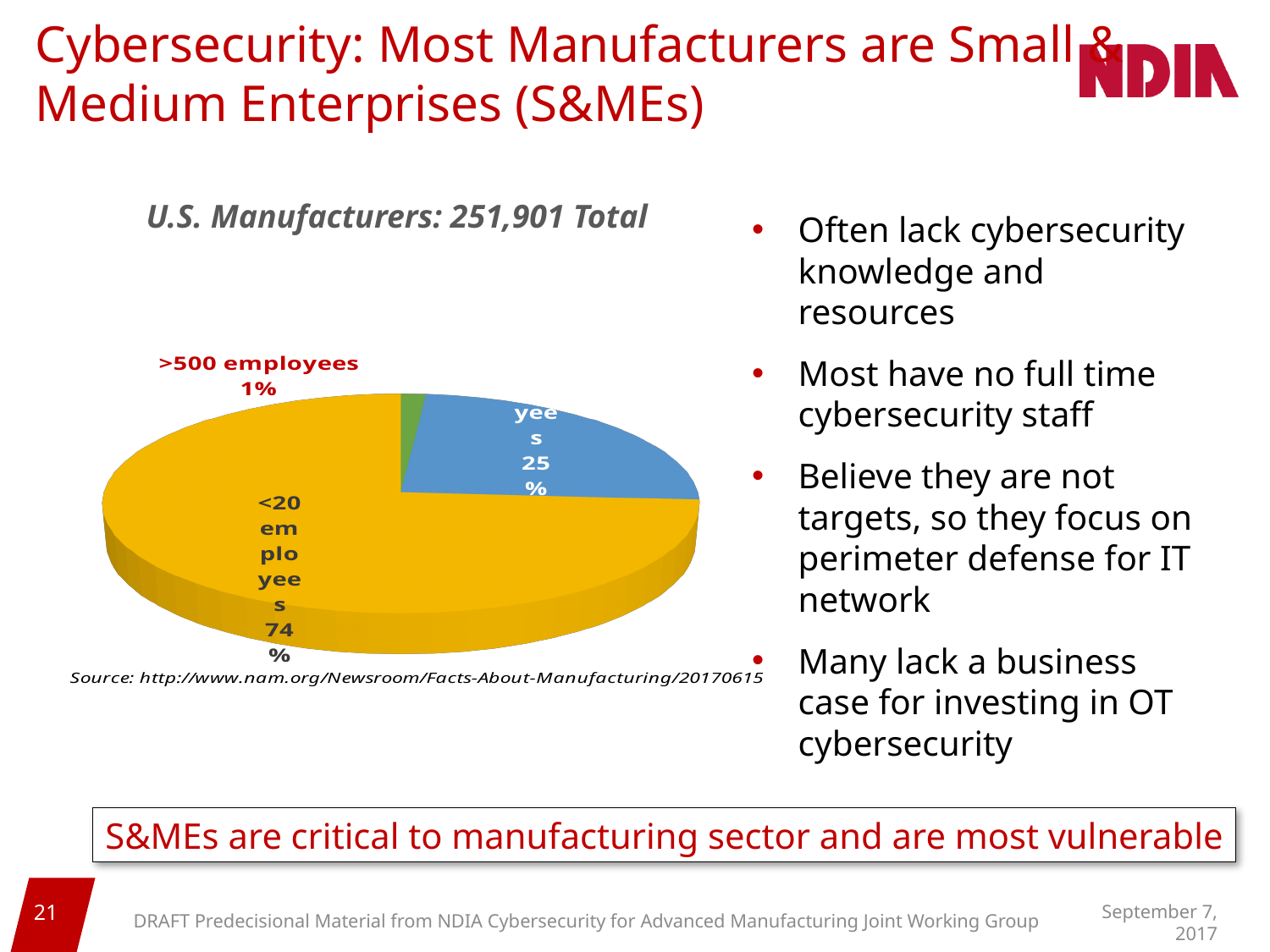
What is the title of the pie chart? U.S. Manufacturers: 251,901 Total What colour is the "<20 employees" slice of the pie chart? Yellow What kind of chart is shown on the slide? Pie chart What share of the pie does the "<20 employees" slice represent? 74% Which slice of the pie chart is the largest? <20 employees What share of the pie does the ">500 employees" slice represent? 1% How many slices does the pie chart have? 3 What percentage is shown on the blue slice of the pie chart? 25% According to the chart title, what is the total number of U.S. manufacturers? 251,901 Which slice of the pie chart is the smallest? >500 employees What is the difference in percentage points between the "<20 employees" slice and the ">500 employees" slice? 73% Which is larger, the "<20 employees" slice or the ">500 employees" slice? <20 employees